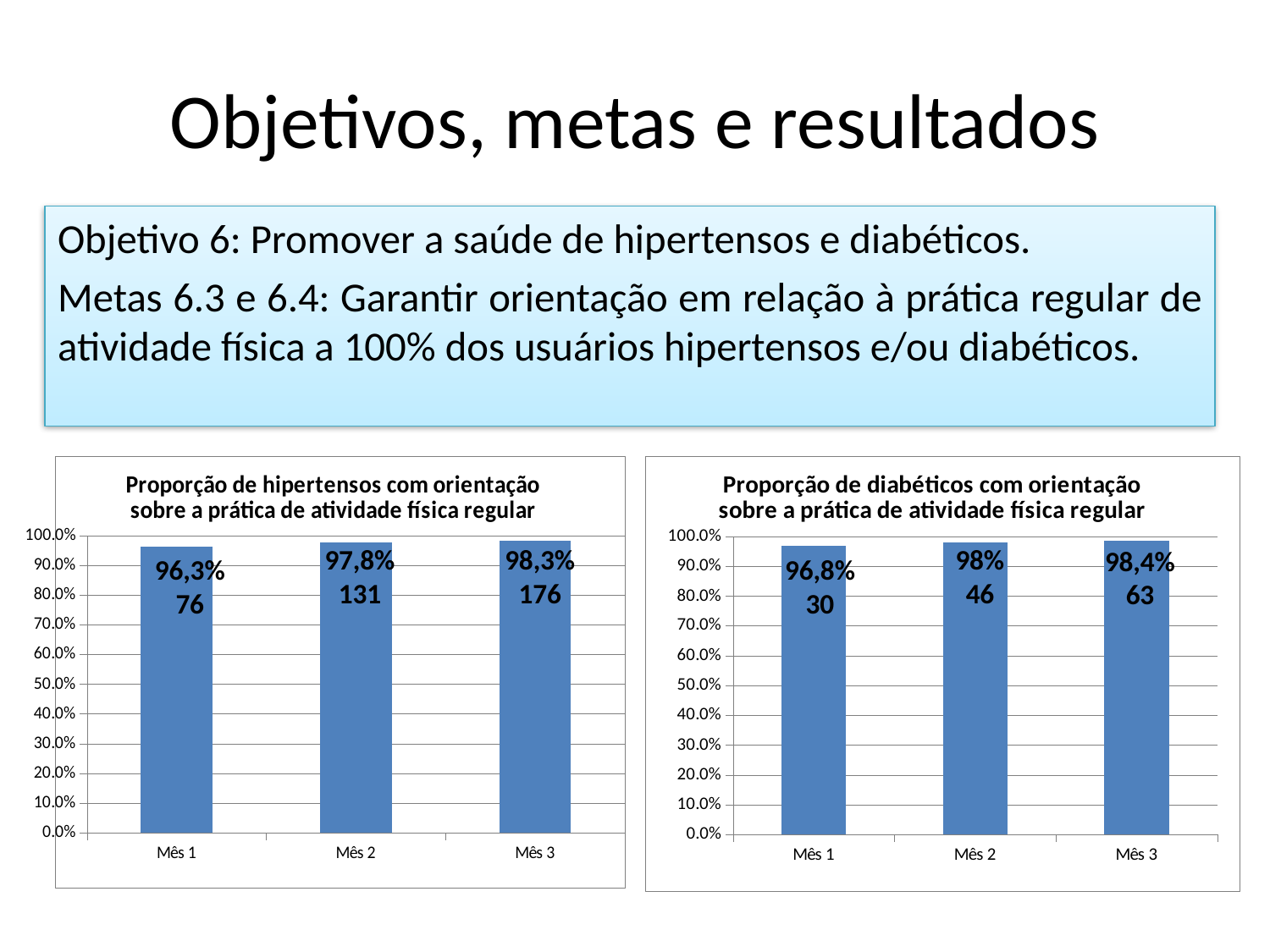
In the left chart (hipertensos), what is the difference between the counts printed for Mês 3 and Mês 1? 100 In the left chart (hipertensos), what count is printed on the bar for Mês 3? 176 What kind of chart is used in the right chart (diabéticos)? Bar chart In the right chart (diabéticos), which month has the lowest percentage? Mês 1 In the left chart (Proporção de hipertensos com orientação sobre a prática de atividade física regular), what percentage is shown for Mês 1? 96,3% In the right chart (diabéticos), what is the difference between the counts printed for Mês 3 and Mês 2? 17 In the right chart (diabéticos), is the value for Mês 1 greater or less than 90.0%? greater In the right chart (Proporção de diabéticos com orientação sobre a prática de atividade física regular), what percentage is shown for Mês 2? 98% In the right chart (diabéticos), what count is printed on the bar for Mês 1? 30 Which is larger: the Mês 2 percentage in the left chart (hipertensos) or the Mês 2 percentage in the right chart (diabéticos)? Right chart (diabéticos), 98% How many months (categories) are shown in the left chart (hipertensos)? 3 In the left chart (hipertensos), which month has the highest percentage? Mês 3